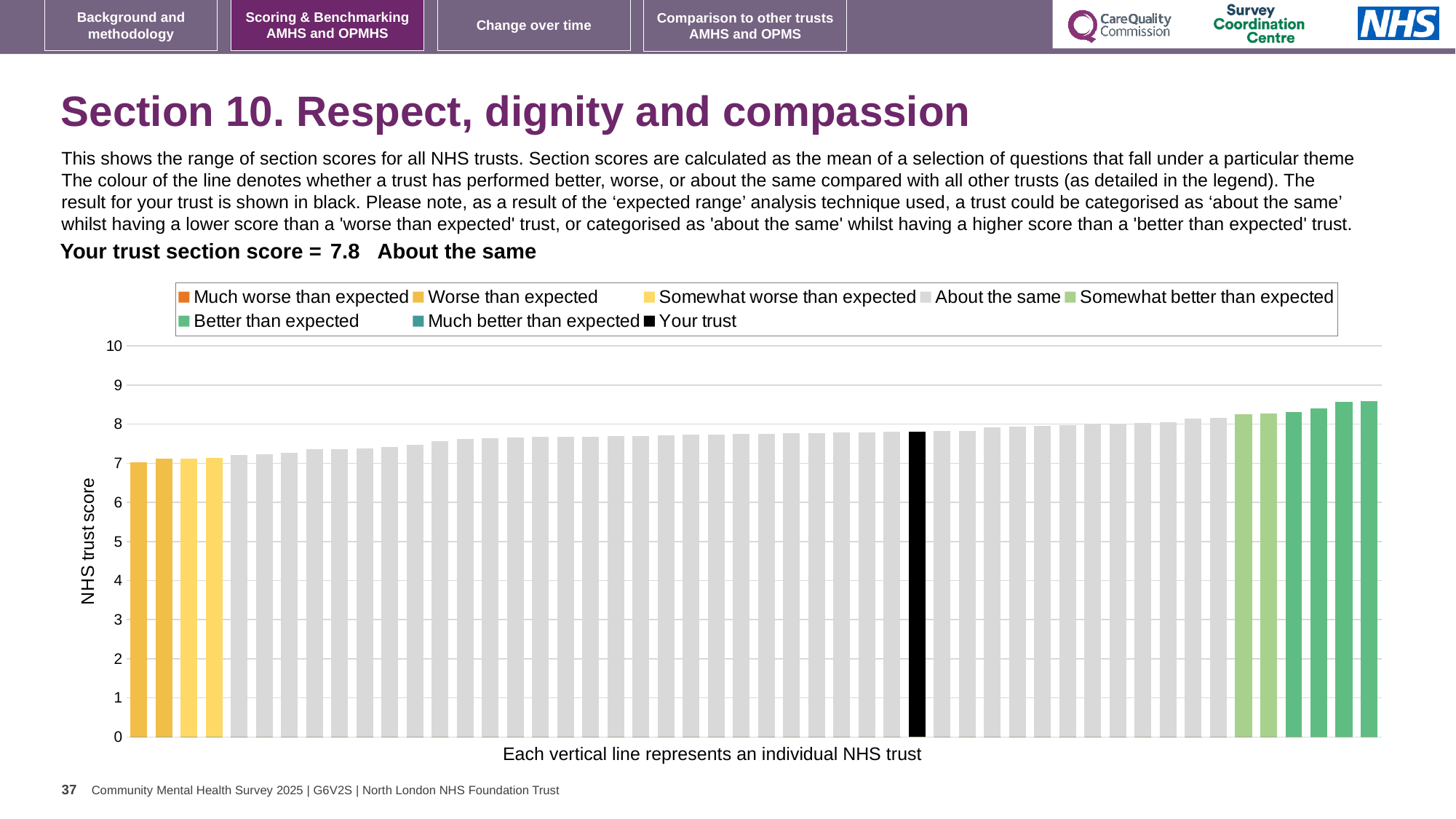
Is the value of the black 'Your trust' bar greater or less than 7? greater Is the value of the leftmost bar greater or less than 6? greater Which category is your trust placed in for this section? About the same How many bars are coloured as 'Better than expected' (dark green)? 4 Is the value of the tallest bar greater or less than 9? less How many entries does the chart legend list? 8 Which bar is taller, the leftmost bar or the rightmost bar? the rightmost bar What is the label on the y axis of the chart? NHS trust score What is the section score for your trust shown on the slide? 7.8 Do the bar values rise or fall from left to right along the x axis? rise What kind of chart is shown on the slide? bar chart